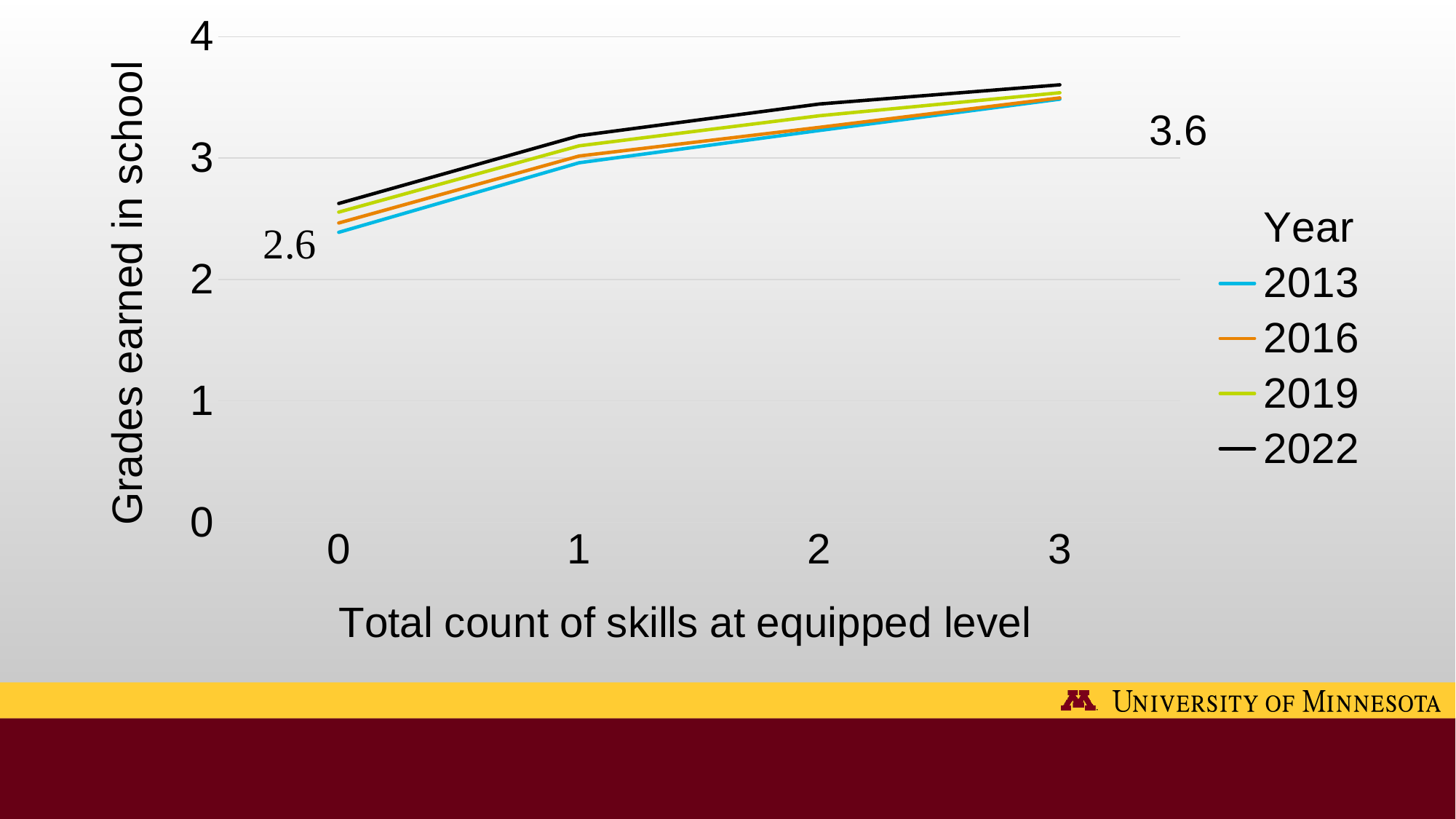
Is the value for 2013 at a skill count of 1 greater or less than 2? greater At a skill count of 0, which line is higher: 2022 or 2013? 2022 Which year's line is lowest at a skill count of 0? 2013 What kind of chart is shown on the slide? line chart How many series does the legend list? 4 What is the title of the legend? Year Do grades earned in school rise or fall as the total count of skills at equipped level increases? rise How many points along the x axis (total count of skills) are plotted for each series? 4 Is the value for 2022 at a skill count of 3 greater or less than 3? greater Is the value for 2013 at a skill count of 0 greater or less than 3? less Which year's line is highest at a skill count of 0? 2022 What is the title of the y axis? Grades earned in school